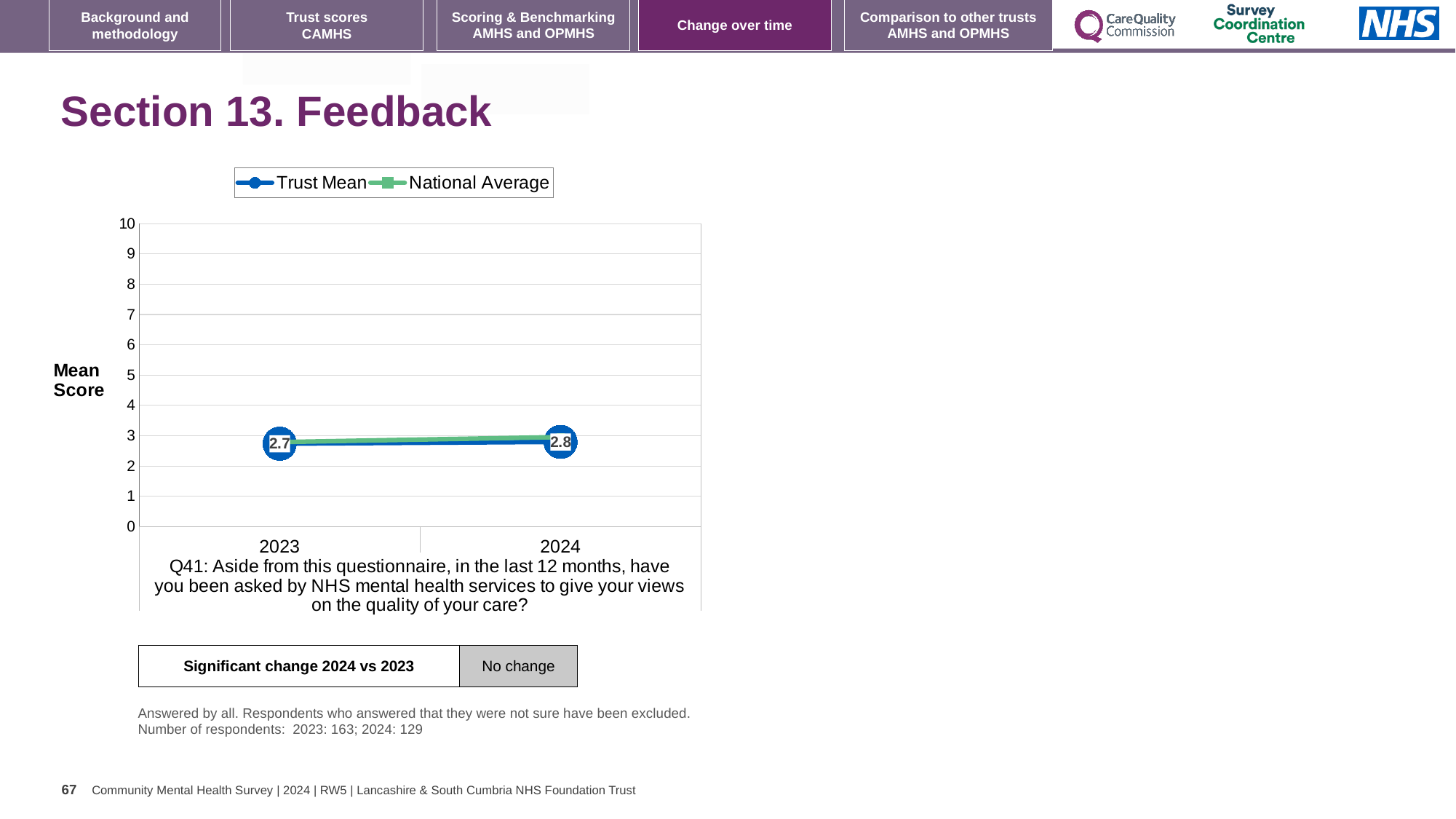
Is the Trust Mean for 2023 greater or less than 5? less What kind of chart is shown on the slide? line chart What is the label on the y axis of the chart? Mean Score What is the Trust Mean value for 2024? 2.8 What is the Trust Mean value for 2023? 2.7 How many series does the legend list? 2 What are the two series named in the legend? Trust Mean and National Average How many years are plotted on the x axis? 2 By how much did the Trust Mean change from 2023 to 2024? 0.1 Is the National Average for 2024 greater or less than 5? less Does the Trust Mean rise or fall from 2023 to 2024? rise Which year has the higher Trust Mean, 2023 or 2024? 2024